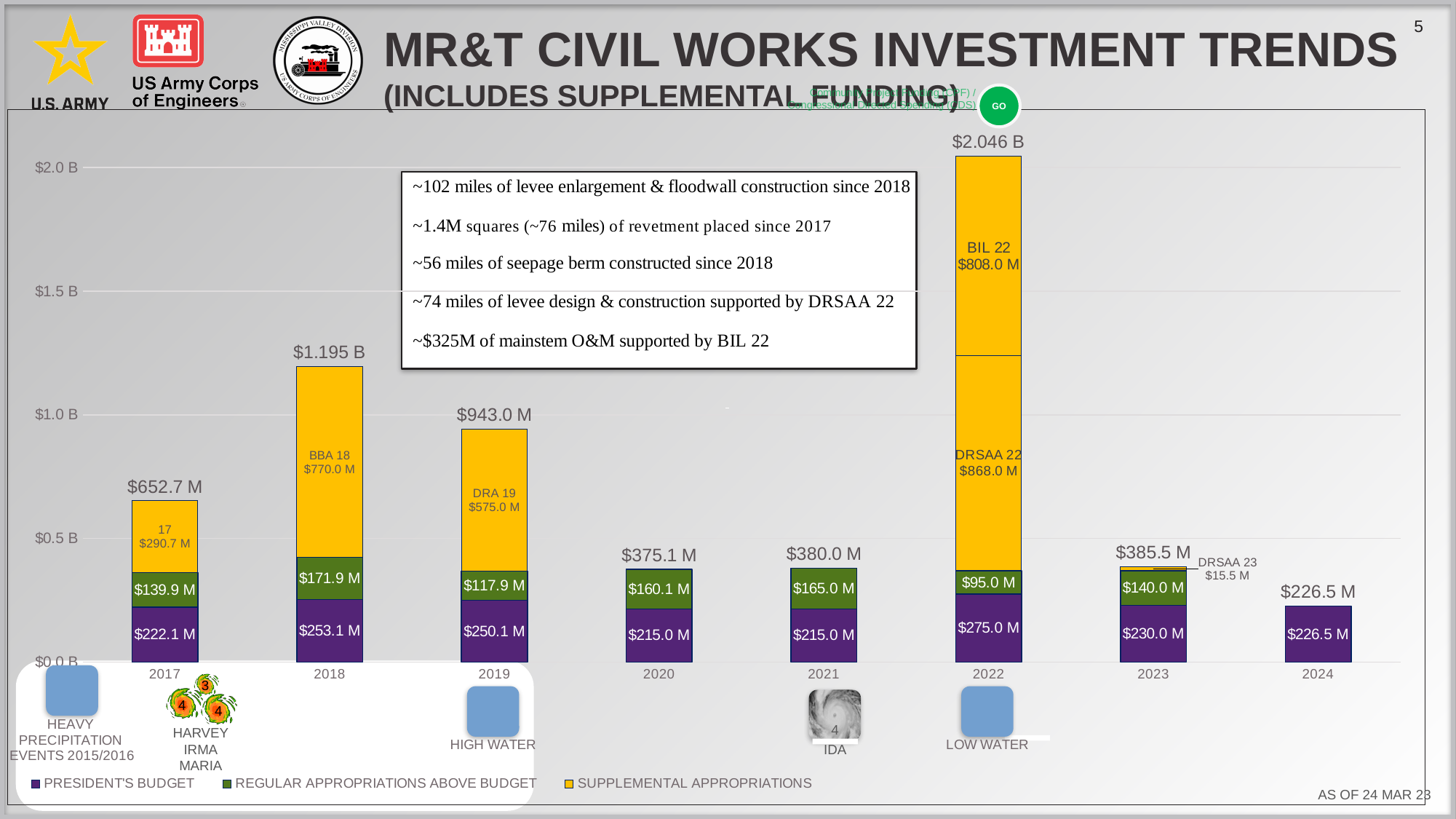
What is the total value shown above the 2022 bar? $2.046 B Is the total for 2017 greater or less than $0.5 B? greater What kind of chart is shown on the slide? Stacked bar chart Which year has the lowest total bar? 2024 Which is larger, the total for 2019 or the total for 2018? 2018 How many years are shown on the x axis? 8 Which year has the highest total bar? 2022 What is the President's Budget value for 2018? $253.1 M How many series does the legend list? 3 What is the difference between the President's Budget values for 2022 and 2020? $60.0 M What is the Regular Appropriations Above Budget value for 2021? $165.0 M What is the BIL 22 supplemental appropriation value shown in the 2022 bar? $808.0 M